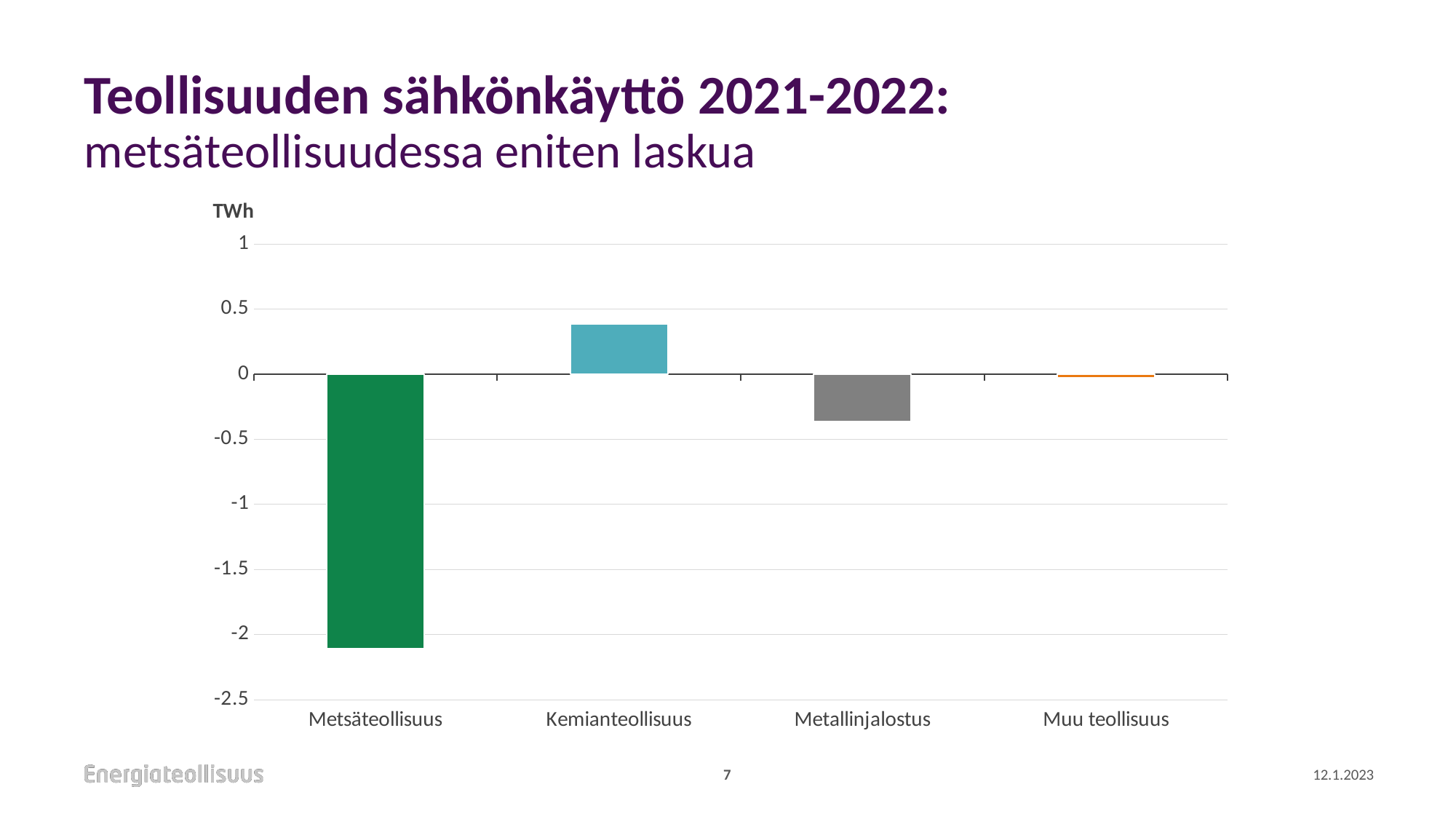
How many categories are shown on the x axis of the chart? 4 Which has the larger value, Kemianteollisuus or Muu teollisuus? Kemianteollisuus Which category has the lowest value in the chart? Metsäteollisuus Which category has the highest value in the chart? Kemianteollisuus Is the value for Metsäteollisuus greater or less than -1? less Is the value for Kemianteollisuus greater or less than 0.5? less Is the value for Metallinjalostus greater or less than -0.5? greater Which has the larger value, Metsäteollisuus or Metallinjalostus? Metallinjalostus What colour is the bar for Metsäteollisuus? green What unit is shown on the y axis of the chart? TWh What kind of chart is shown on the slide? bar chart